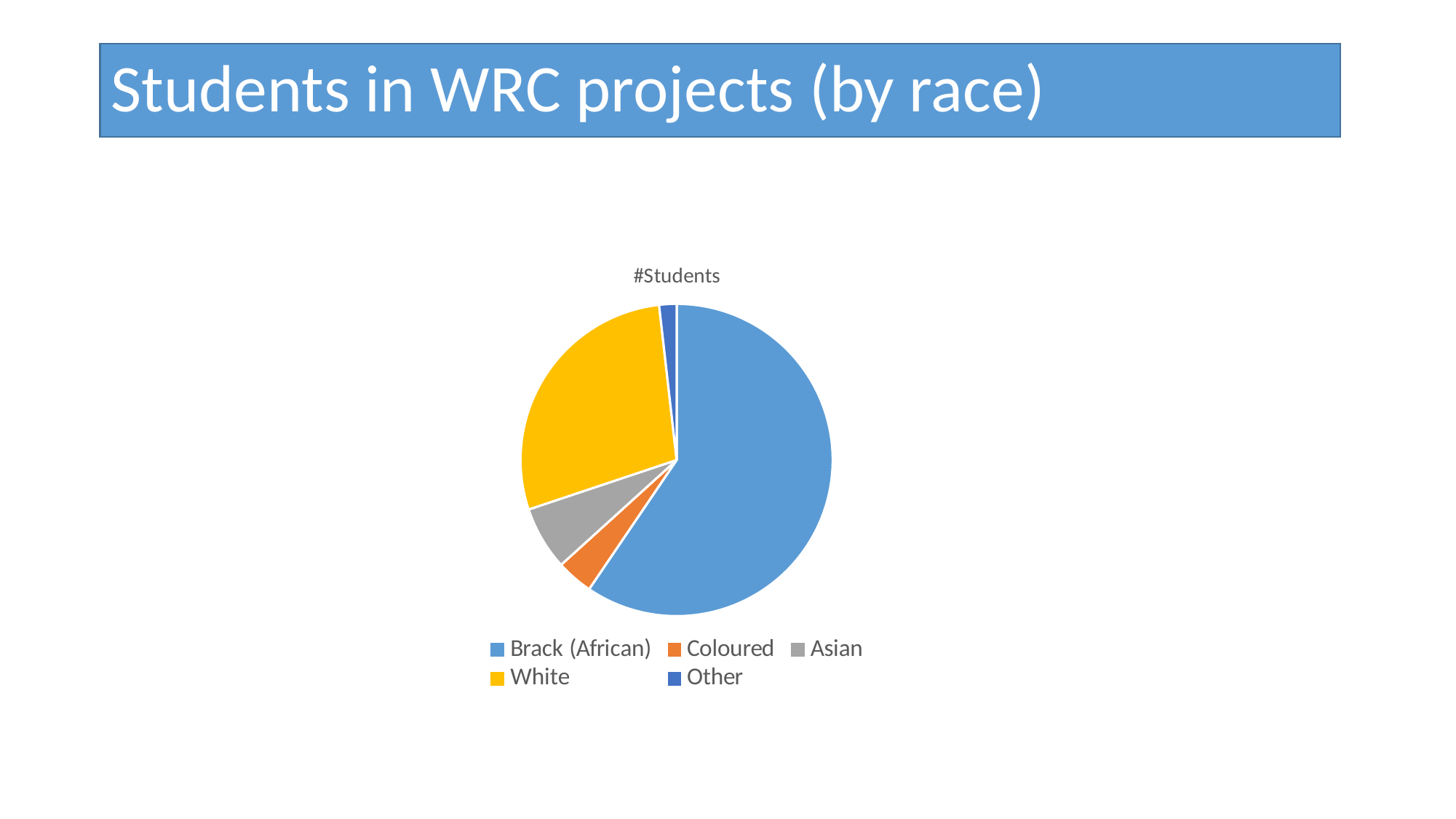
How many categories does the pie chart show? 5 Which slice is larger, White or Asian? White Which slice is larger, Coloured or Other? Coloured What colour is the White slice in the pie chart? yellow Which slice is larger, Asian or Coloured? Asian Which category has the largest slice of the pie chart? Brack (African) Which category has the smallest slice of the pie chart? Other What is the title shown above the pie chart? #Students What kind of chart is shown on the slide? pie chart